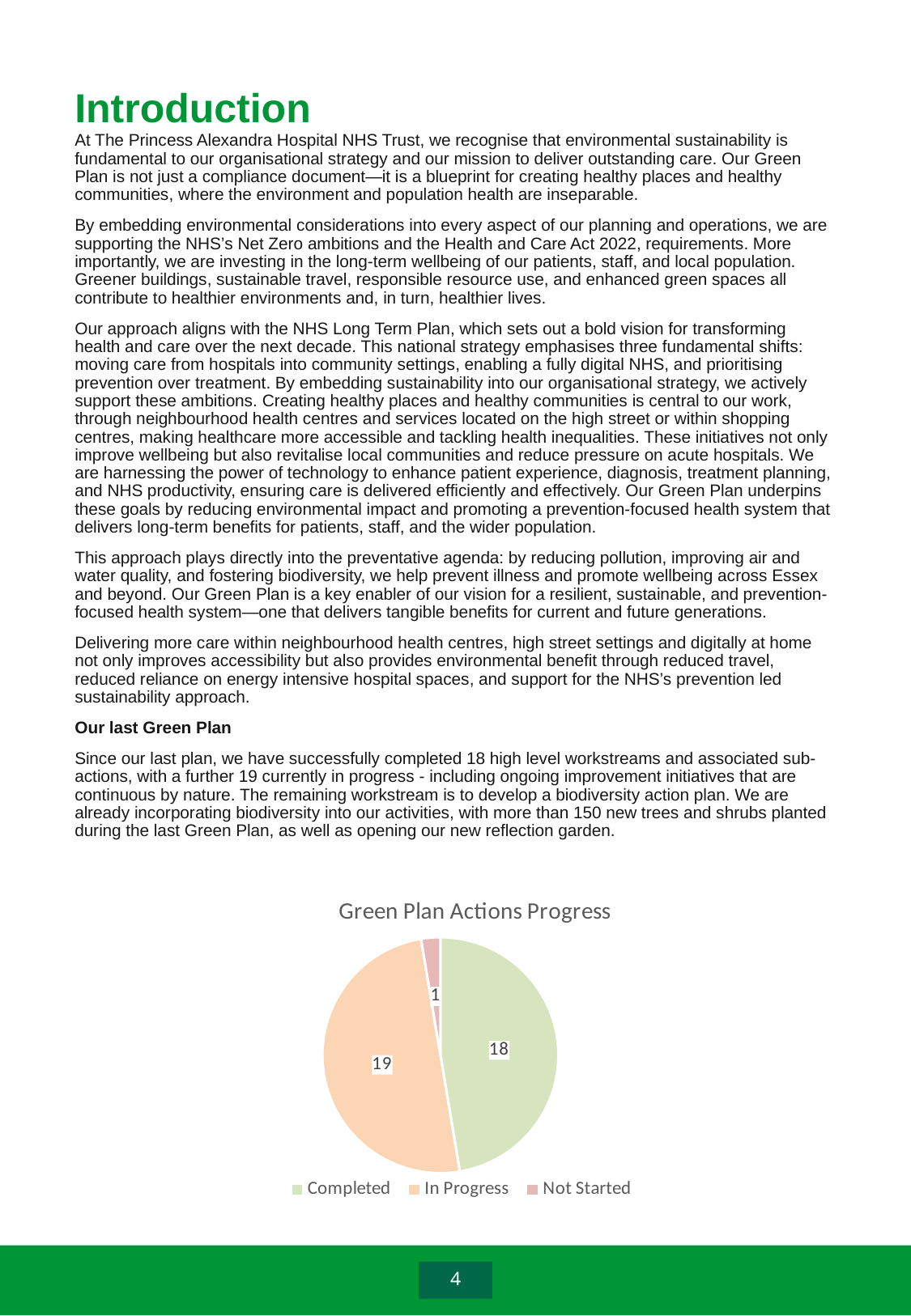
Which is larger in the pie chart, Completed or Not Started? Completed Which category has the smallest slice in the pie chart? Not Started How many actions are shown as In Progress in the pie chart? 19 How many actions are shown as Not Started in the pie chart? 1 What share of the pie chart does the In Progress slice represent? 50% What is the title of the chart on the slide? Green Plan Actions Progress What is the total of all slices in the pie chart? 38 How many categories does the pie chart show? 3 Which category has the largest slice in the pie chart? In Progress What is the difference between the In Progress and Completed values in the pie chart? 1 How many actions are shown as Completed in the pie chart? 18 What type of chart is shown under the title 'Green Plan Actions Progress'? pie chart